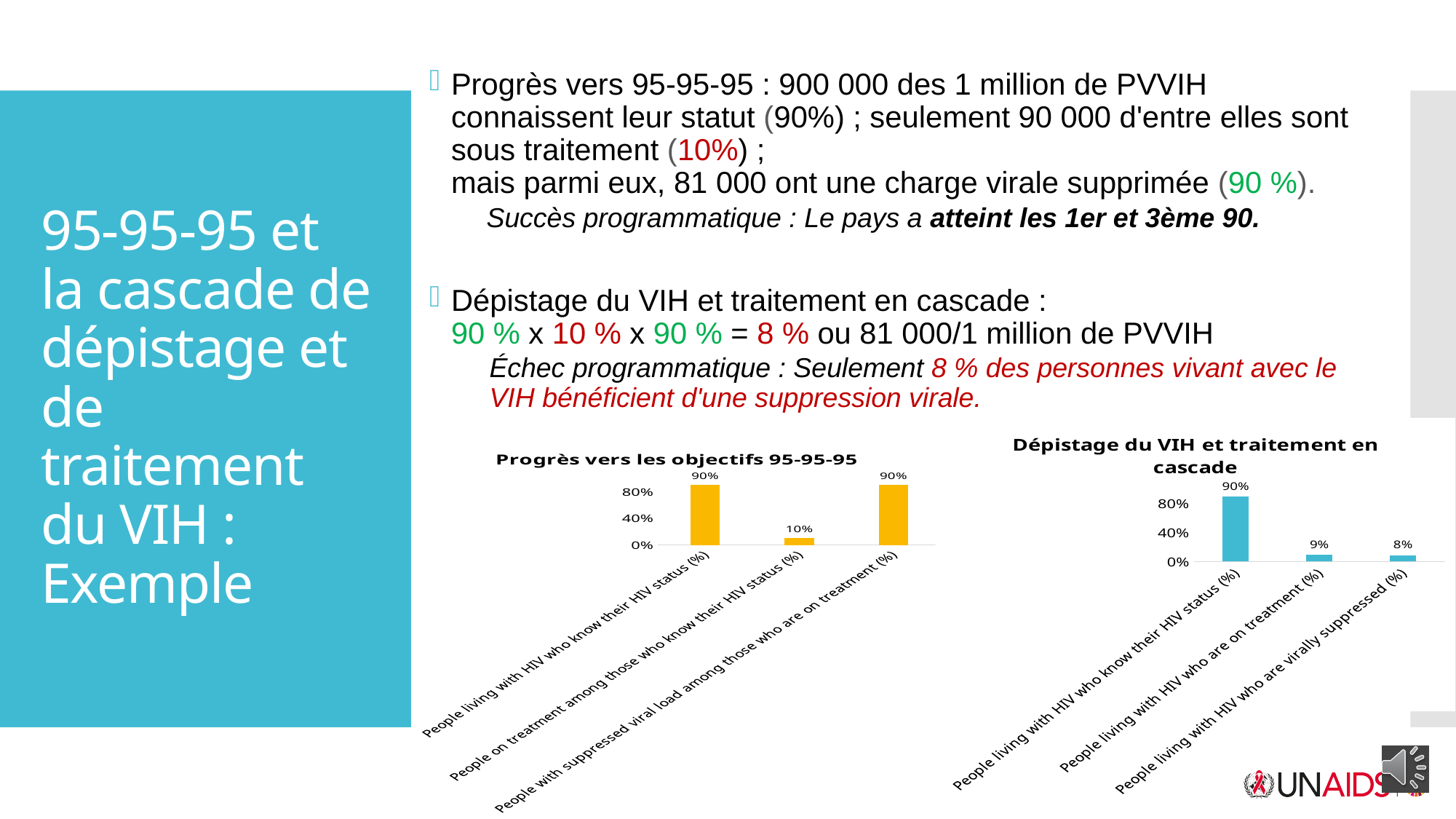
What kind of chart is the one titled "Progrès vers les objectifs 95-95-95"? Bar chart In the chart titled "Dépistage du VIH et traitement en cascade", which category has the highest value? People living with HIV who know their HIV status (%) In the chart titled "Dépistage du VIH et traitement en cascade", do the values rise or fall from left to right? Fall What colour are the bars in the chart titled "Dépistage du VIH et traitement en cascade"? Blue In the chart titled "Progrès vers les objectifs 95-95-95", what is the value for "People on treatment among those who know their HIV status (%)"? 10% In the chart titled "Progrès vers les objectifs 95-95-95", which category has the lowest value? People on treatment among those who know their HIV status (%) In the chart titled "Progrès vers les objectifs 95-95-95", how many bars are plotted? 3 In the chart titled "Dépistage du VIH et traitement en cascade", what is the difference between the value for "People living with HIV who know their HIV status (%)" and the value for "People living with HIV who are virally suppressed (%)"? 82% In the chart titled "Dépistage du VIH et traitement en cascade", what is the value for "People living with HIV who are virally suppressed (%)"? 8% In the chart titled "Progrès vers les objectifs 95-95-95", what is the difference between the value for "People with suppressed viral load among those who are on treatment (%)" and the value for "People on treatment among those who know their HIV status (%)"? 80% In the chart titled "Progrès vers les objectifs 95-95-95", what is the value for "People living with HIV who know their HIV status (%)"? 90% In the chart titled "Dépistage du VIH et traitement en cascade", what is the value for "People living with HIV who are on treatment (%)"? 9%